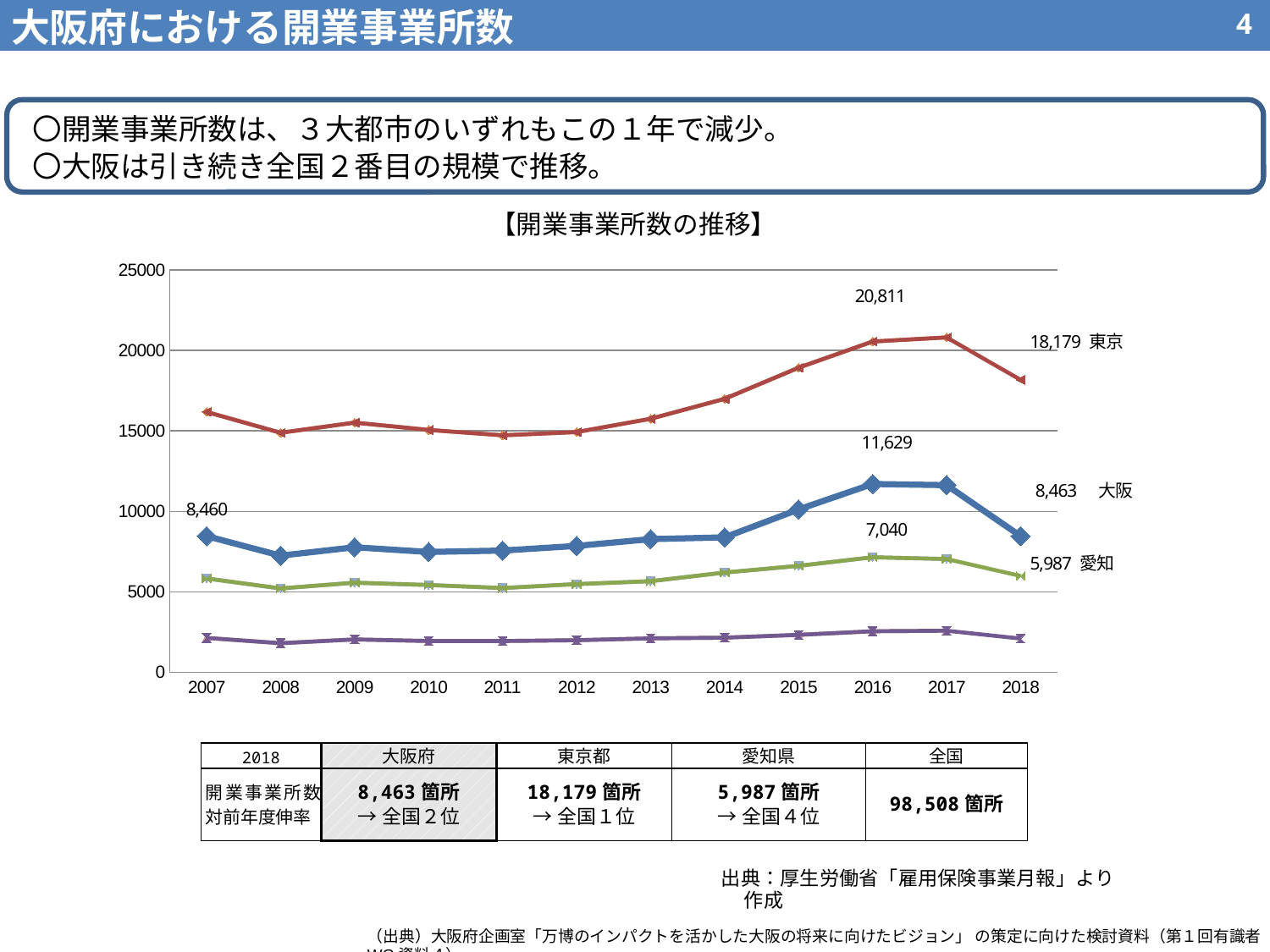
What is the difference between the 大阪 and 愛知 values in 2018? 2,476 What is the value for 大阪 in 2018? 8,463 Is the value for 東京 in 2016 greater or less than 20000? greater What is the value for 愛知 in 2018? 5,987 Does the 東京 line rise or fall from 2017 to 2018? fall How many years are shown on the x axis? 12 What is the value for 大阪 in 2007? 8,460 Which line has the highest value in 2018? 東京 What kind of chart is shown on the slide? line chart What is the difference between the 東京 and 大阪 values in 2018? 9,716 What is the value for 東京 in 2018? 18,179